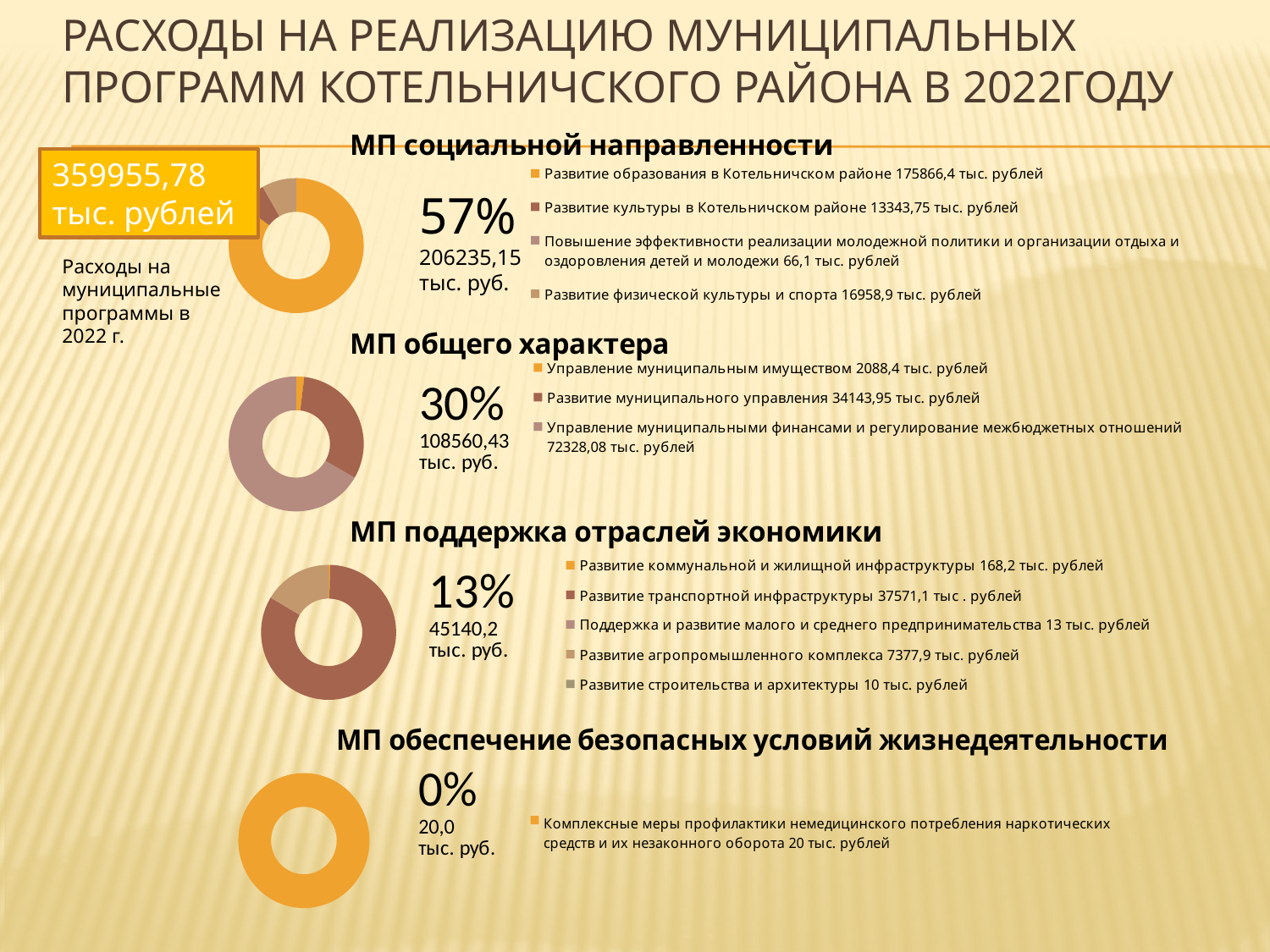
What kind of chart is used for "МП социальной направленности"? Doughnut chart In the chart titled "МП социальной направленности", what is the value for "Развитие образования в Котельничском районе"? 175866,4 тыс. рублей In the chart titled "МП поддержка отраслей экономики", which legend entry has the highest value? Развитие транспортной инфраструктуры In the chart titled "МП общего характера", what is the value for "Развитие муниципального управления"? 34143,95 тыс. рублей In the chart titled "МП общего характера", which is larger: "Управление муниципальными финансами и регулирование межбюджетных отношений" or "Развитие муниципального управления"? Управление муниципальными финансами и регулирование межбюджетных отношений In the chart titled "МП социальной направленности", which legend entry has the highest value? Развитие образования в Котельничском районе How many legend entries does the chart titled "МП общего характера" list? 3 In the chart titled "МП поддержка отраслей экономики", what is the value for "Развитие агропромышленного комплекса"? 7377,9 тыс. рублей In the chart titled "МП социальной направленности", which legend entry has the lowest value? Повышение эффективности реализации молодежной политики и организации отдыха и оздоровления детей и молодежи In the chart titled "МП социальной направленности", what is the difference between the values for "Развитие физической культуры и спорта" and "Развитие культуры в Котельничском районе"? 3615,15 тыс. рублей What share of total expenditure does the chart titled "МП обеспечение безопасных условий жизнедеятельности" show? 0% How many categories does the chart titled "МП поддержка отраслей экономики" list in its legend? 5